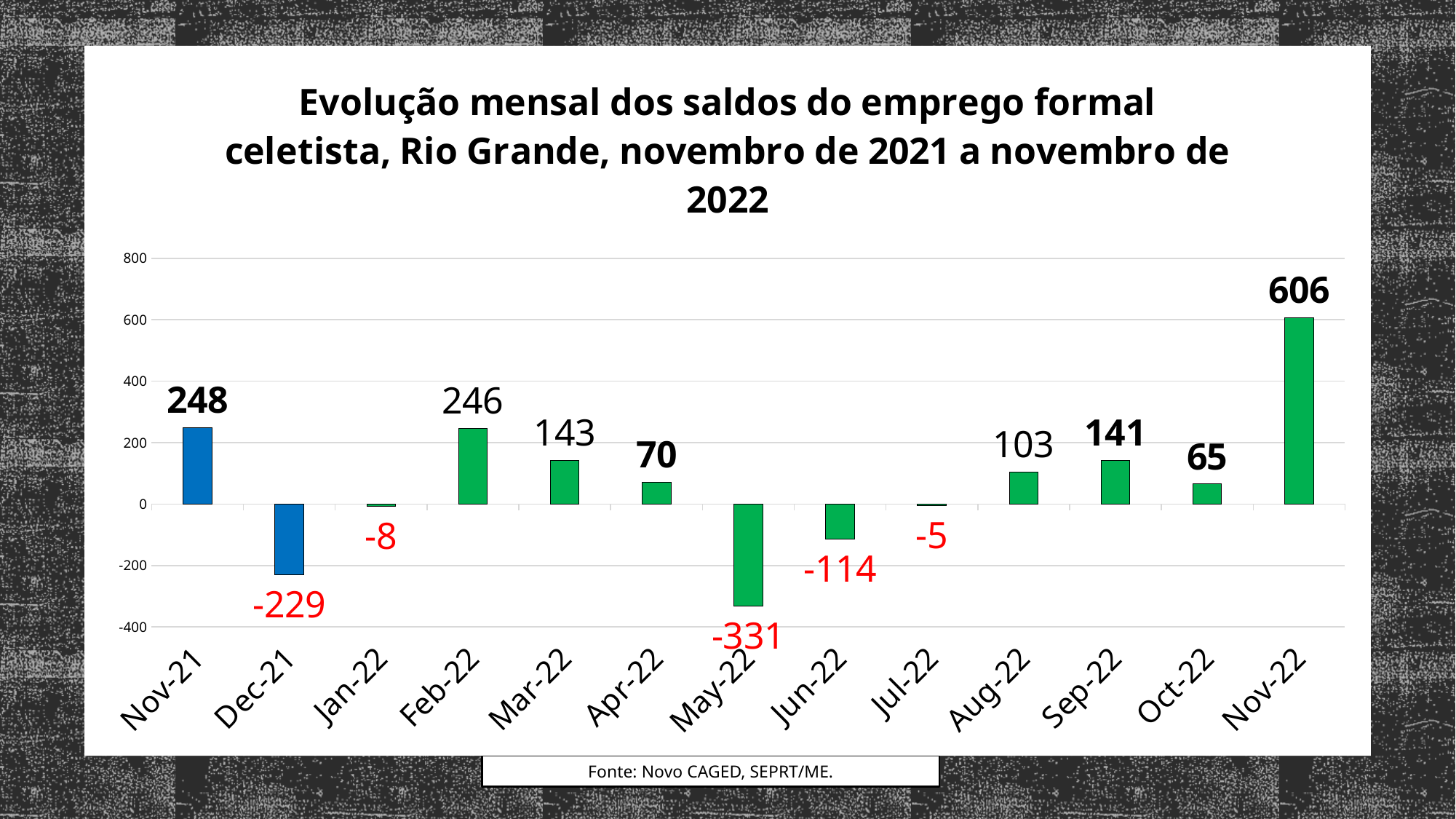
Which is larger, the value for Mar-22 or the value for Sep-22? Mar-22 What is the value for May-22? -331 What kind of chart is shown on the slide? bar chart What is the value for Nov-22? 606 What is the difference between the values for Nov-22 and Nov-21? 358 What is the value for Jul-22? -5 What is the value for Feb-22? 246 What source is cited below the chart? Novo CAGED, SEPRT/ME. Is the value for Dec-21 greater or less than -200? less Which month has the highest value? Nov-22 How many months are shown on the x axis? 13 Which month has the lowest value? May-22